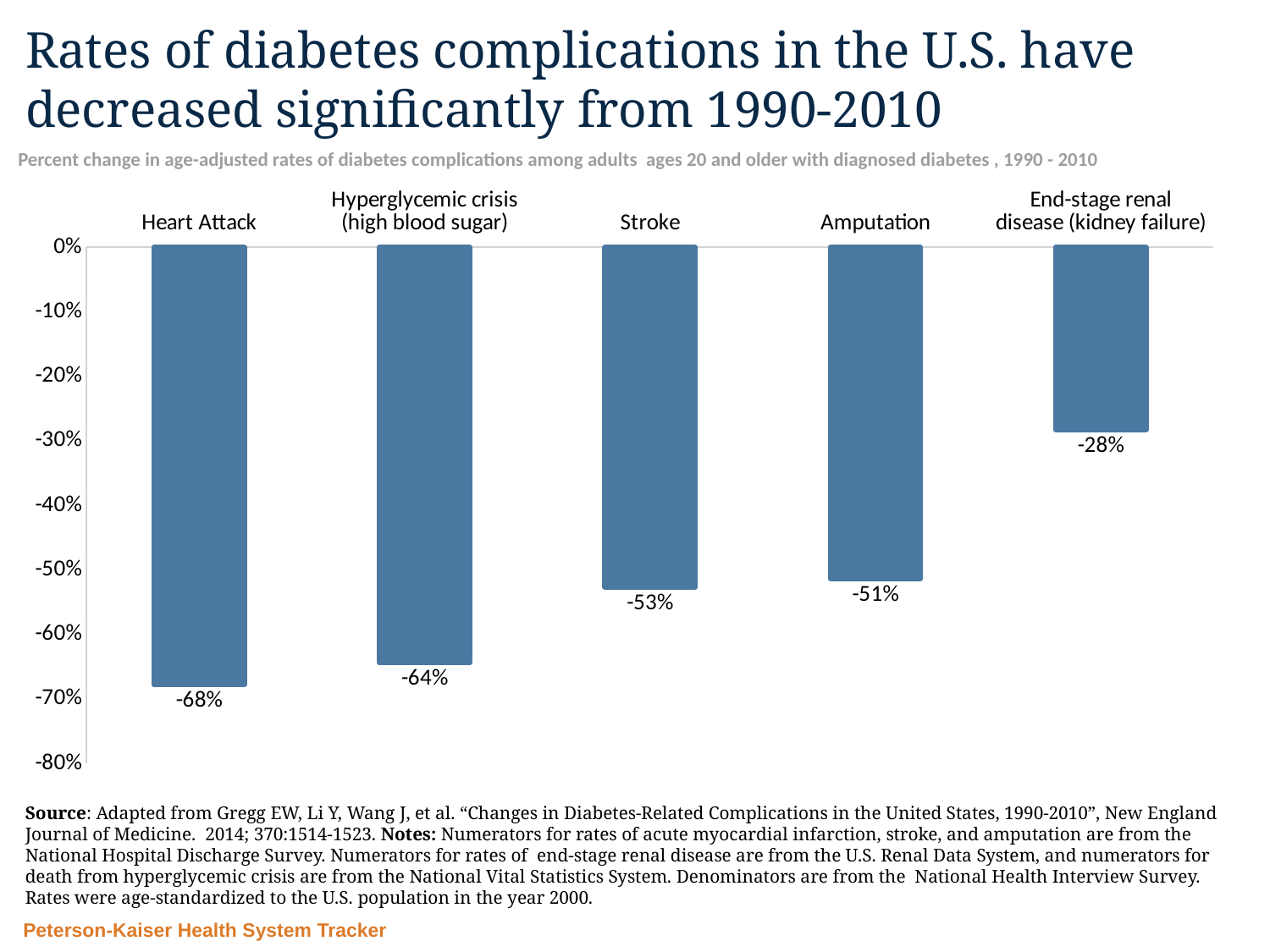
Which decreased more, Stroke or Amputation? Stroke What is the percent change for Hyperglycemic crisis (high blood sugar)? -64% What is the percent change for Heart Attack? -68% Which complication shows the largest decrease? Heart Attack What is the percent change for Stroke? -53% What type of chart is shown on the slide? Bar chart What is the difference between the percent change for Heart Attack and for End-stage renal disease (kidney failure)? 40 percentage points What is the percent change for Amputation? -51% How many complication categories are shown in the chart? 5 Which complication shows the smallest decrease? End-stage renal disease (kidney failure) What is the lowest value shown on the vertical axis? -80% What is the percent change for End-stage renal disease (kidney failure)? -28%